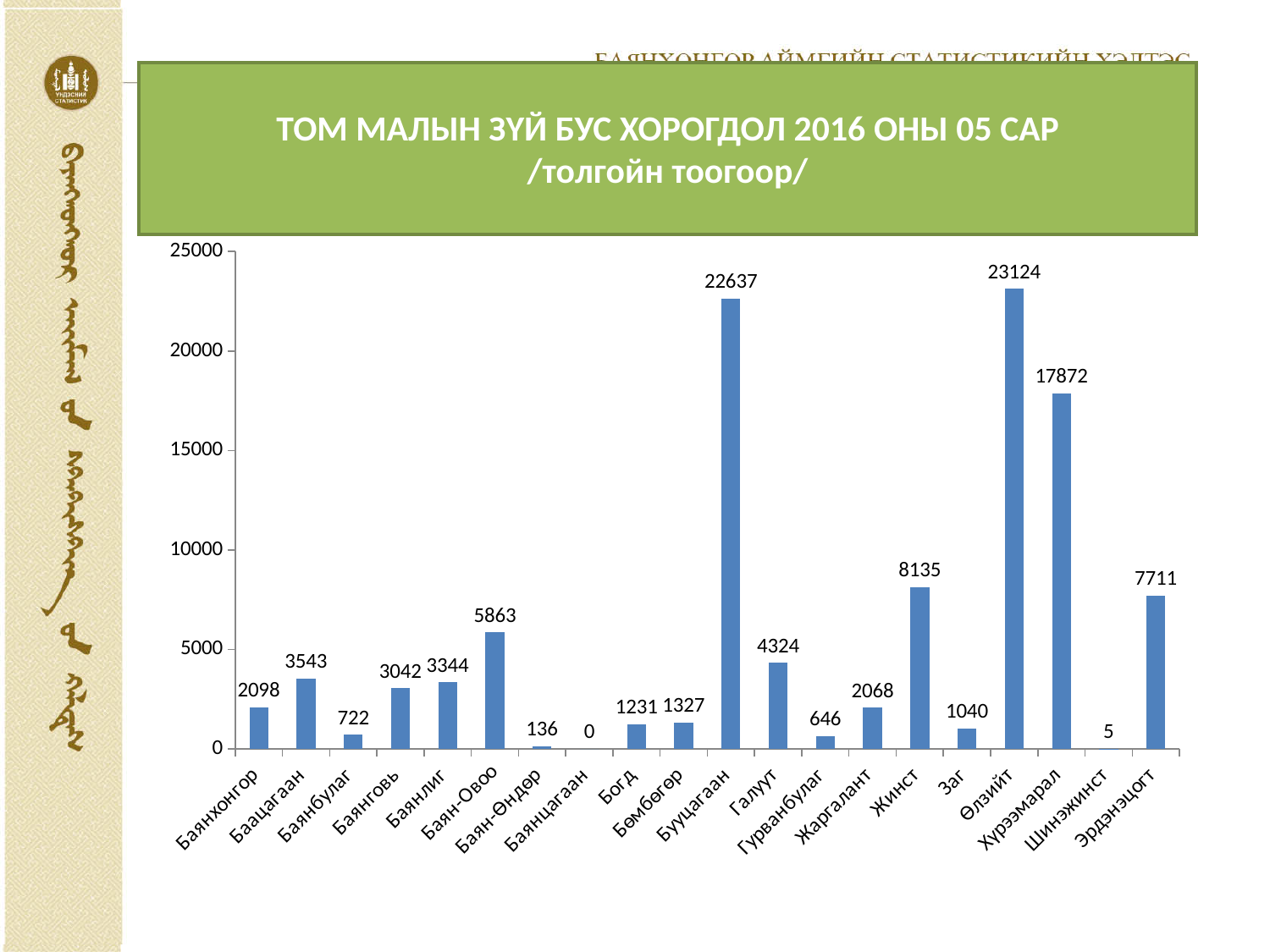
Which category has the lowest value? Баянцагаан Which category has the highest value? Өлзийт What is the difference between the values for Жинст and Эрдэнэцогт? 424 What is the value for Хүрээмарал? 17872 What kind of chart is shown on the slide? bar chart Is the value for Галуут greater or less than 5000? less What is the difference between the values for Өлзийт and Бууцагаан? 487 Which is larger, the value for Баянговь or the value for Баянлиг? Баянлиг What is the value for Бууцагаан? 22637 What is the value for Баян-Овоо? 5863 What is the value for Шинэжинст? 5 How many categories are shown on the x axis? 20